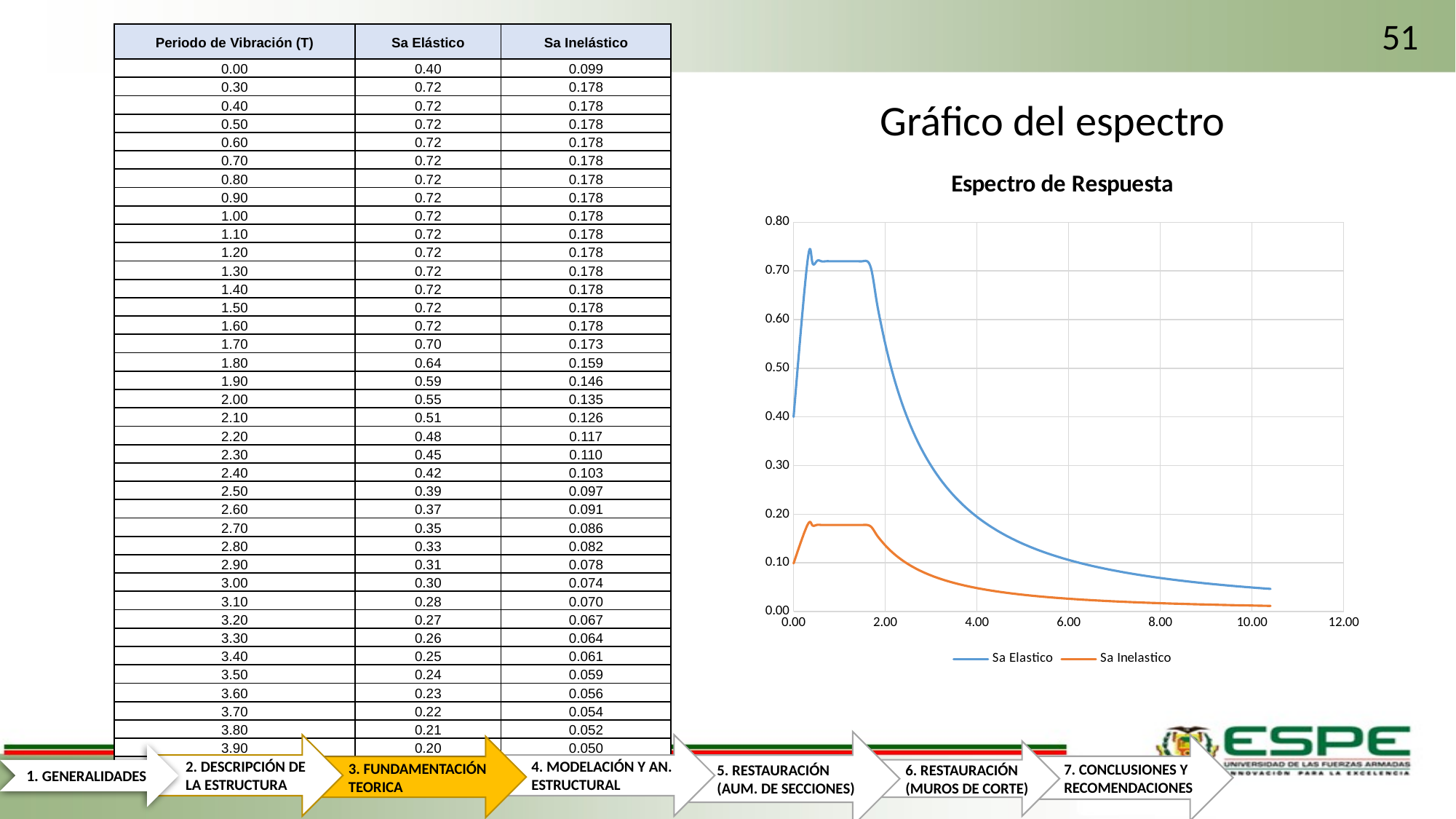
In the 'Espectro de Respuesta' chart, what is the value of Sa Elastico at a period of 0.00? 0.40 In the 'Espectro de Respuesta' chart, is the value of Sa Inelastico at a period of 2.00 greater or less than 0.20? less In the 'Espectro de Respuesta' chart, does the Sa Elastico line rise or fall as the period increases from 2.00 to 10.00? fall In the 'Espectro de Respuesta' chart, which series is higher at a period of 4.00, Sa Elastico or Sa Inelastico? Sa Elastico How many series does the legend of the 'Espectro de Respuesta' chart list? 2 In the 'Espectro de Respuesta' chart, is the value of Sa Inelastico at a period of 8.00 greater or less than 0.10? less In the 'Espectro de Respuesta' chart, is the highest value reached by Sa Elastico greater or less than 0.70? greater What kind of chart is 'Espectro de Respuesta'? line chart In the 'Espectro de Respuesta' chart, which series reaches the lowest values, Sa Elastico or Sa Inelastico? Sa Inelastico What are the two series named in the legend of the 'Espectro de Respuesta' chart? Sa Elastico and Sa Inelastico What is the title of the chart on the slide? Espectro de Respuesta